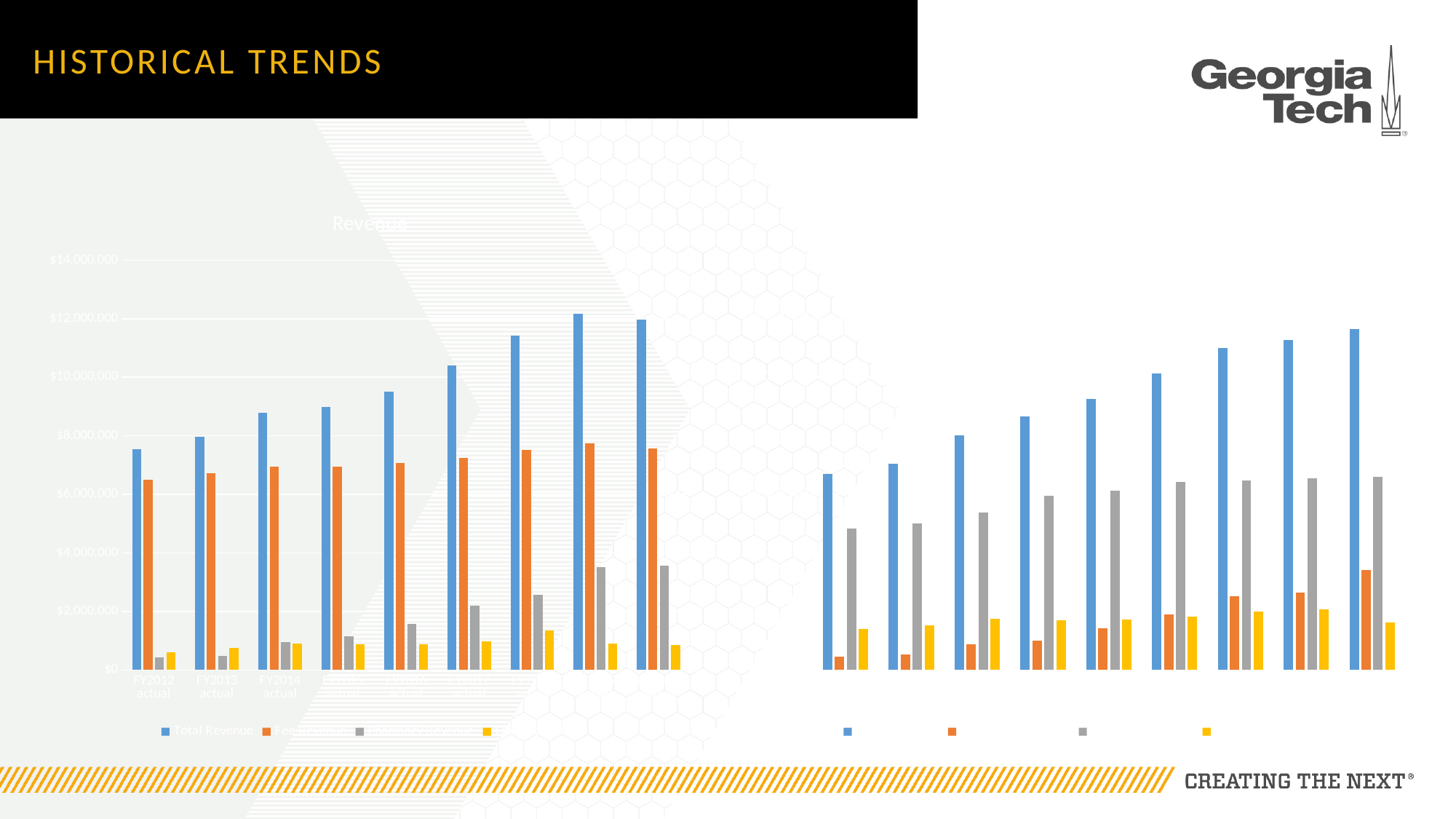
In the chart on the right side of the slide, how many groups of bars are plotted along the x axis? 9 In the left chart titled "Revenue", which has the larger Total Revenue, FY2012 actual or FY2014 actual? FY2014 actual What is the title of the left chart? Revenue What kind of chart is the left chart titled "Revenue"? bar chart In the left chart titled "Revenue", is the Total Revenue value for FY2012 actual greater or less than $6,000,000? greater In the left chart titled "Revenue", how many groups of bars are plotted along the x axis? 9 In the left chart titled "Revenue", does Total Revenue rise or fall from FY2012 actual to FY2014 actual? rise In the left chart titled "Revenue", is the Total Revenue value for FY2012 actual greater or less than $8,000,000? less What kind of chart is the chart on the right side of the slide? bar chart In the left chart titled "Revenue", what colour are the Total Revenue bars? blue In the left chart titled "Revenue", is the Total Revenue value for FY2014 actual greater or less than $8,000,000? greater In the left chart titled "Revenue", how many series does the legend list? 4